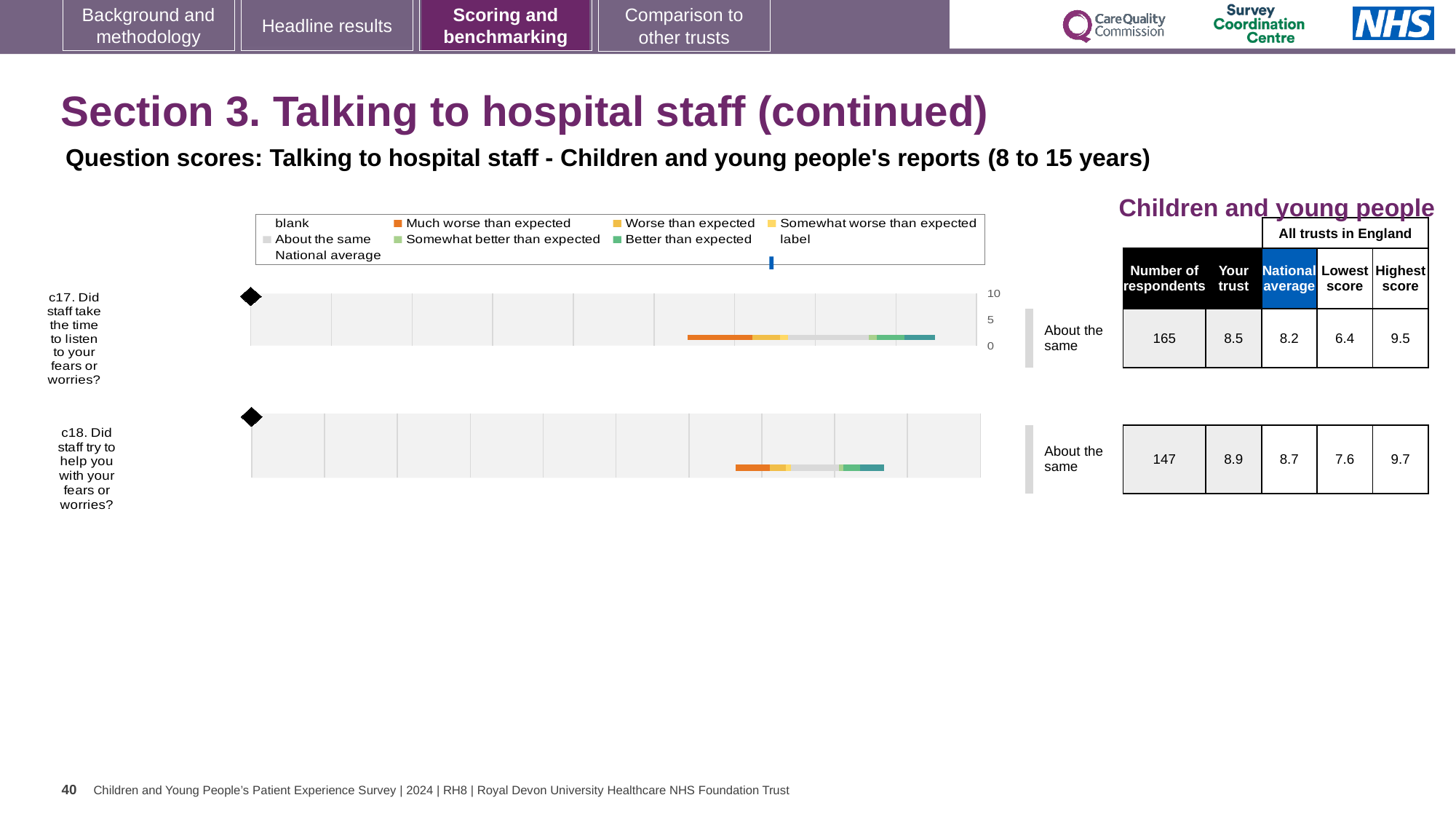
What is the lowest score across all trusts in England for c17? 6.4 Which question has more respondents, c17 or c18? c17 What benchmark category is shown for c17 (Did staff take the time to listen to your fears or worries?)? About the same What type of chart is used to show the question scores? Bar chart What is the difference between the highest and lowest scores across all trusts for c17? 3.1 How many questions are plotted on the chart? 2 What is the 'Your trust' score for c17 (Did staff take the time to listen to your fears or worries?)? 8.5 What is the difference between the 'Your trust' score and the national average for c18? 0.2 What is the highest score across all trusts in England for c18? 9.7 Which question, c17 or c18, has the higher 'Your trust' score? c18 What is the national average score for c18 (Did staff try to help you with your fears or worries?)? 8.7 How many respondents answered question c17? 165